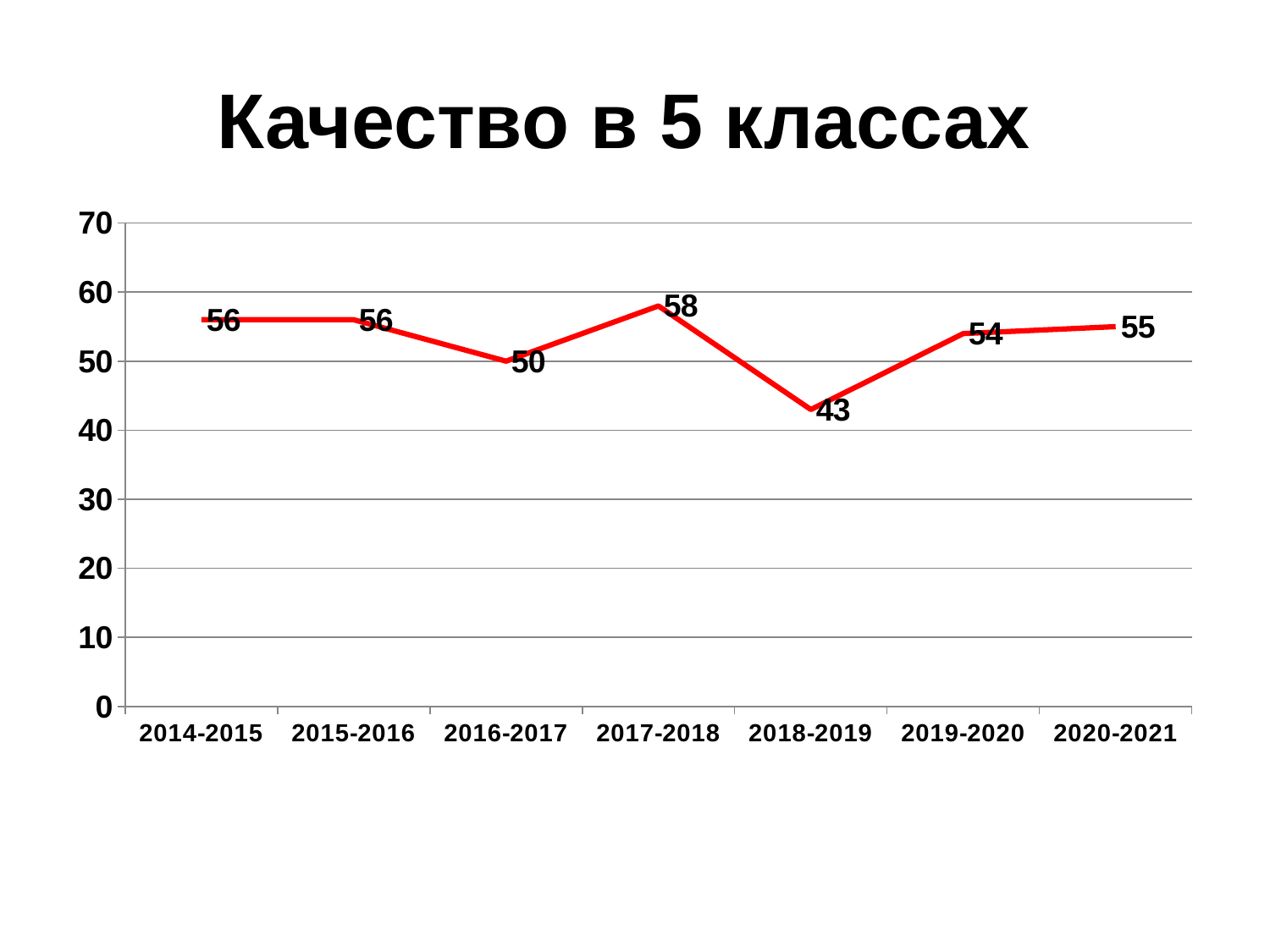
What is the difference between the values for 2017-2018 and 2018-2019? 15 What is the title of the chart? Качество в 5 классах What is the value for 2018-2019? 43 Which year has the lowest value? 2018-2019 What is the value for 2014-2015? 56 Does the value rise or fall from 2018-2019 to 2019-2020? rise How many years are plotted on the chart? 7 Which is larger, the value for 2016-2017 or the value for 2019-2020? 2019-2020 Is the value for 2018-2019 greater or less than 50? less Which year has the highest value? 2017-2018 What kind of chart is shown on the slide? line chart What is the value for 2020-2021? 55